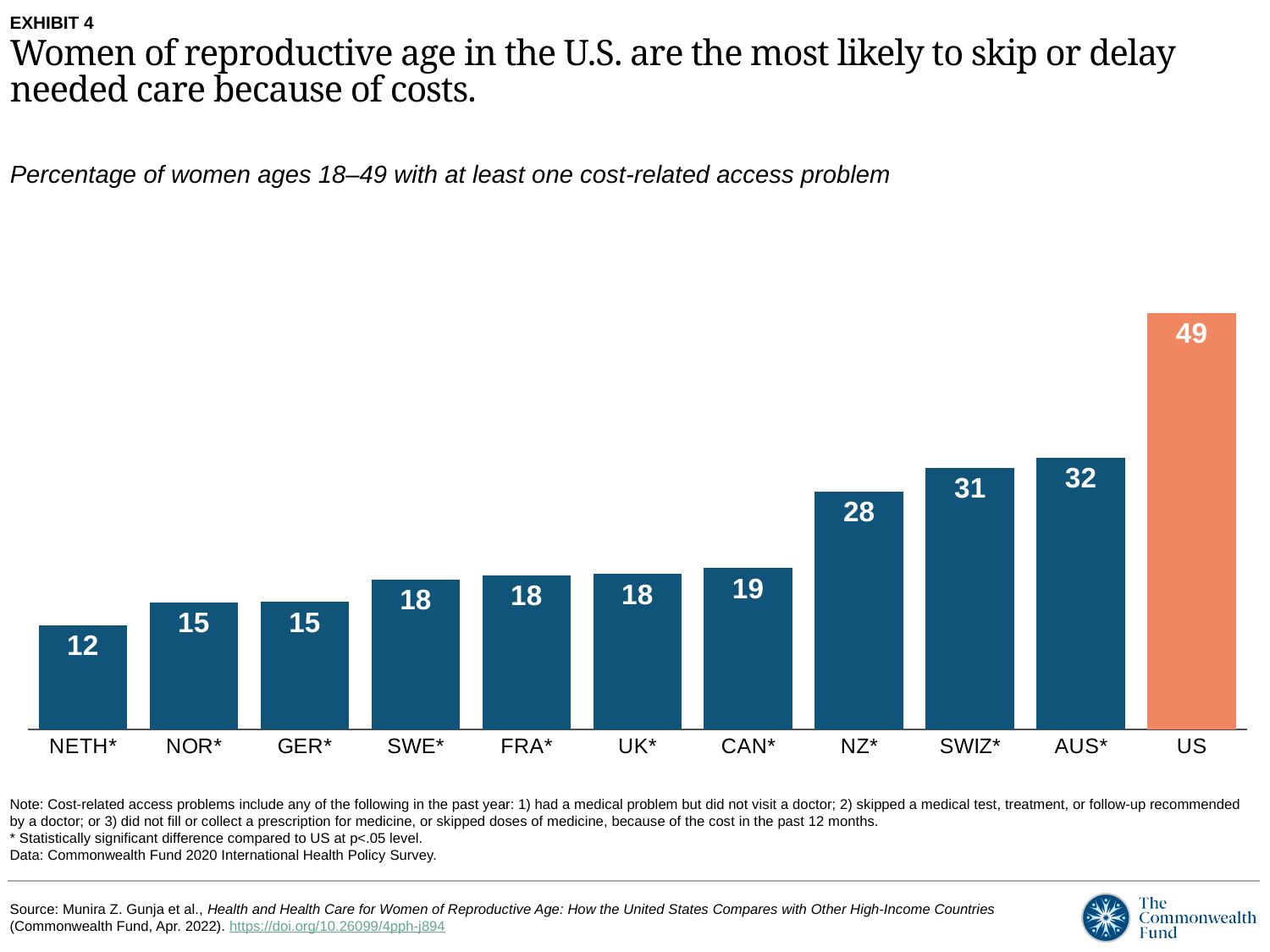
What is the difference between the values for the US and AUS*? 17 Which has a larger value, NZ* or CAN*? NZ* Which country has the highest value? US Which country has the lowest value? NETH* What is the value for NZ*? 28 What is the value for CAN*? 19 What kind of chart is shown on the slide? Bar chart What is the difference between the values for SWIZ* and NETH*? 19 Which bar is shown in a different colour from the others? US Do the values rise or fall from left to right across the chart? Rise How many countries are shown in the chart? 11 What is the value for the US? 49